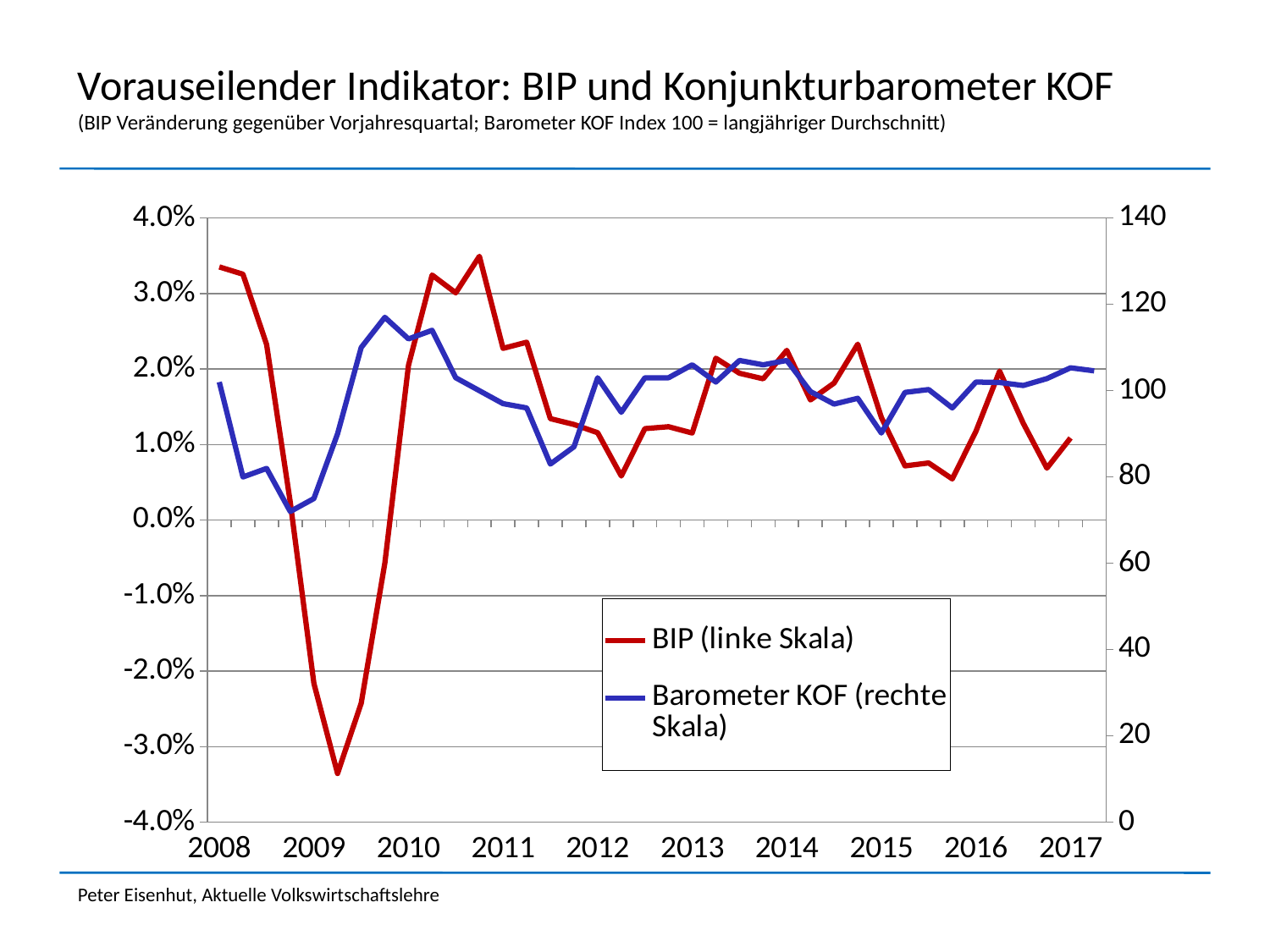
How many series does the legend list? 2 Is the lowest value of the Barometer KOF line greater or less than 80? less Is the lowest value of the BIP line greater or less than -3.0%? less Which is higher, the BIP value at the start of 2008 or the BIP value at the start of 2009? start of 2008 What kind of chart is shown on the slide? line chart In which year does the BIP line reach its lowest value? 2009 Does the BIP line rise or fall between the start of 2008 and the start of 2009? fall How many years are labelled on the x axis? 10 What colour is the BIP line? red Is the highest value of the Barometer KOF line greater or less than 100? greater Which series is plotted against the right-hand scale according to the legend? Barometer KOF (rechte Skala)